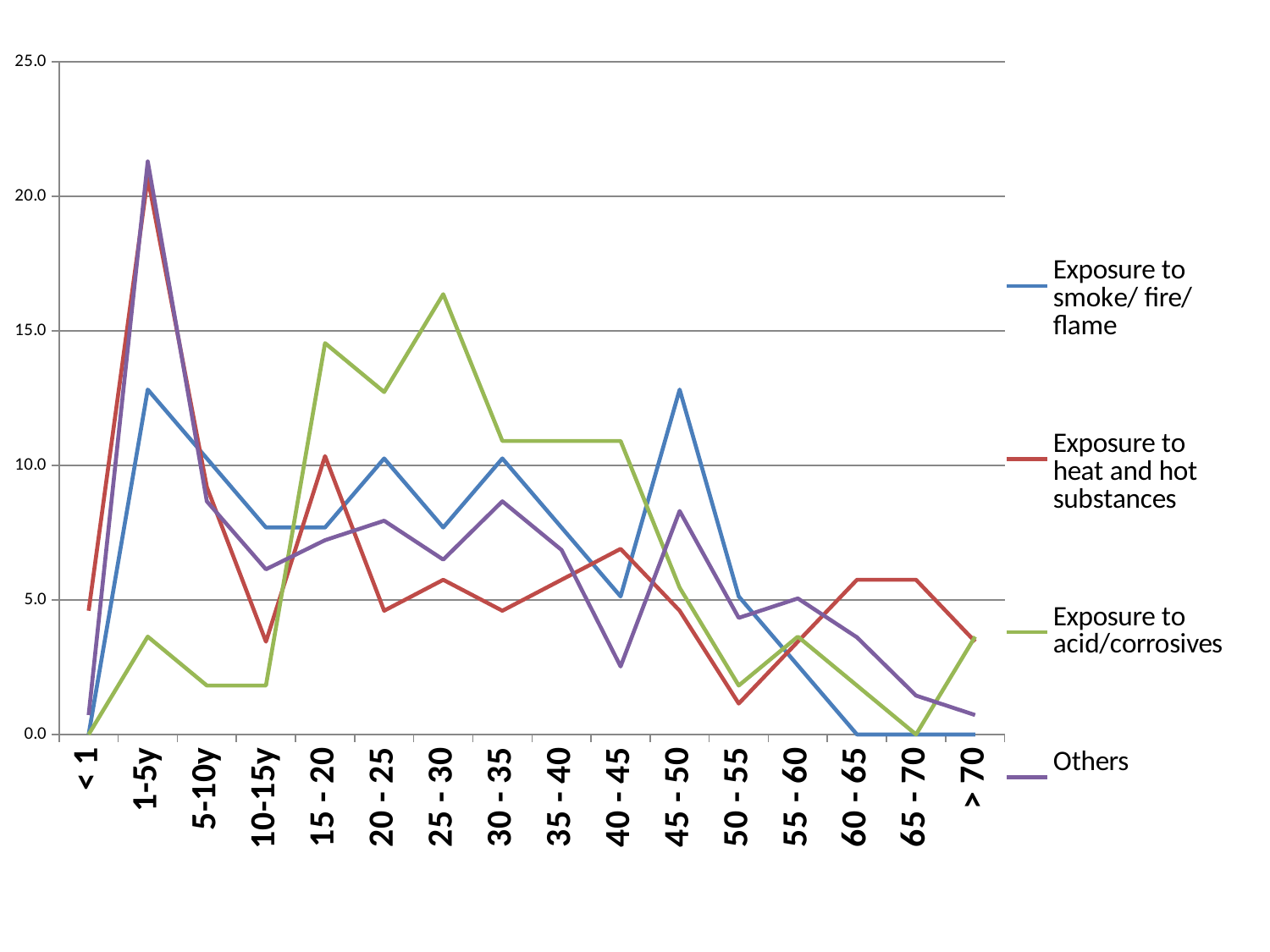
Which series is drawn in green in the legend? Exposure to acid/corrosives How many age-group categories are shown on the x axis? 16 Is the value for Exposure to acid/corrosives at 25 - 30 greater or less than 15.0? greater Is the value for Exposure to smoke/ fire/ flame at 60 - 65 greater or less than 5.0? less In which age group does the Exposure to acid/corrosives line reach its highest value? 25 - 30 In which age group does the Exposure to heat and hot substances line reach its lowest value? 50 - 55 Does the Exposure to smoke/ fire/ flame line rise or fall from 45 - 50 to 60 - 65? fall At 25 - 30, which is larger: Exposure to acid/corrosives or Exposure to smoke/ fire/ flame? Exposure to acid/corrosives What kind of chart is shown on the slide? line chart Is the value for Others at 1-5y greater or less than 20.0? greater In which age group does the Others line reach its highest value? 1-5y How many series does the legend list? 4